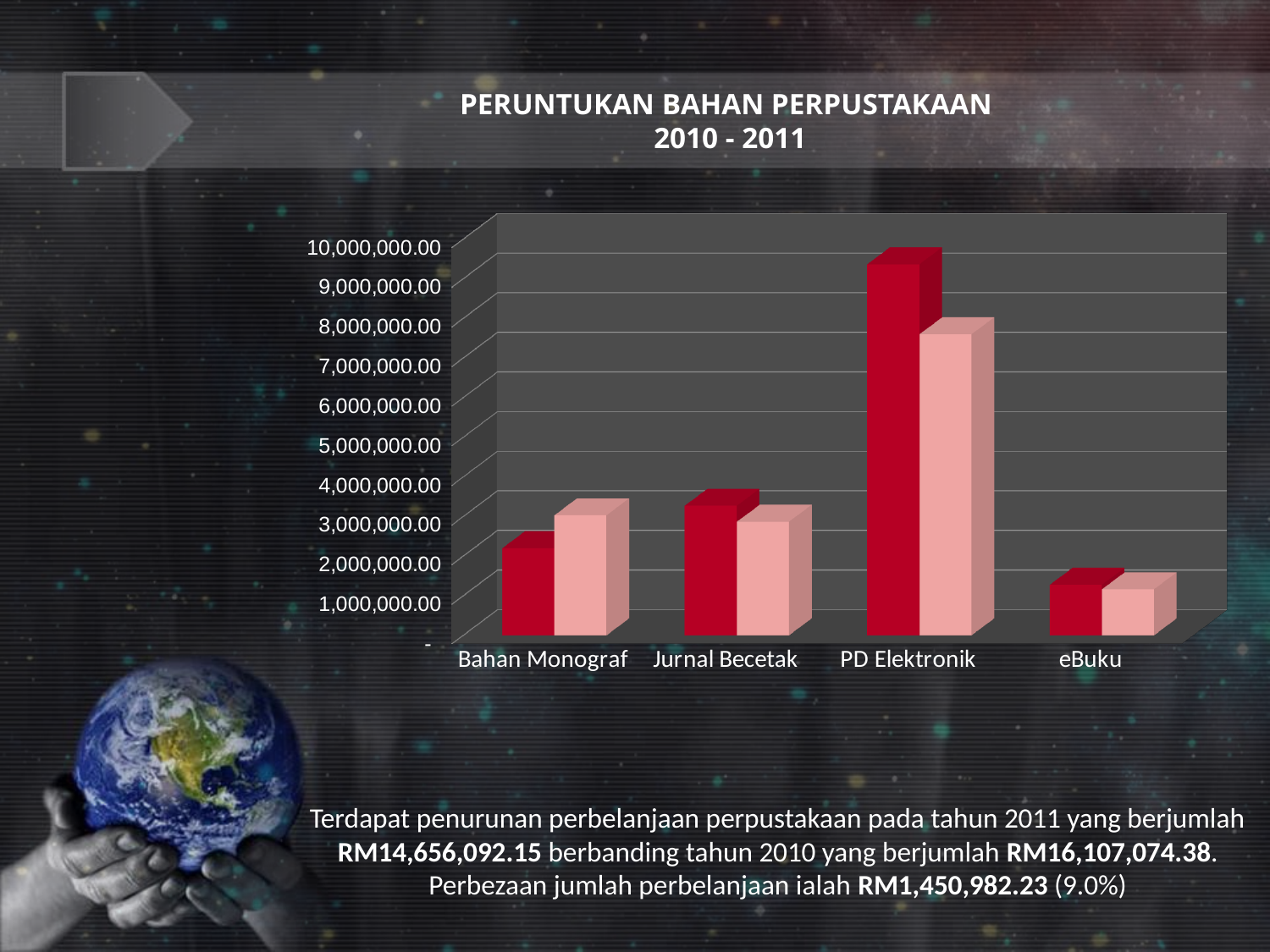
What is the title of the chart? PERUNTUKAN BAHAN PERPUSTAKAAN 2010 - 2011 Which category has the lowest bars in the chart? eBuku How many categories are shown on the x axis of the chart? 4 Is the dark red bar for PD Elektronik greater or less than 8,000,000.00? greater Which category has the highest bars in the chart? PD Elektronik What kind of chart is shown on the slide? bar chart Is the pink bar for PD Elektronik greater or less than 7,000,000.00? greater How many bars are plotted for each category in the chart? 2 For Bahan Monograf, which bar is taller, the dark red bar or the pink bar? the pink bar Is the dark red bar for eBuku greater or less than 2,000,000.00? less For PD Elektronik, which bar is taller, the dark red bar or the pink bar? the dark red bar